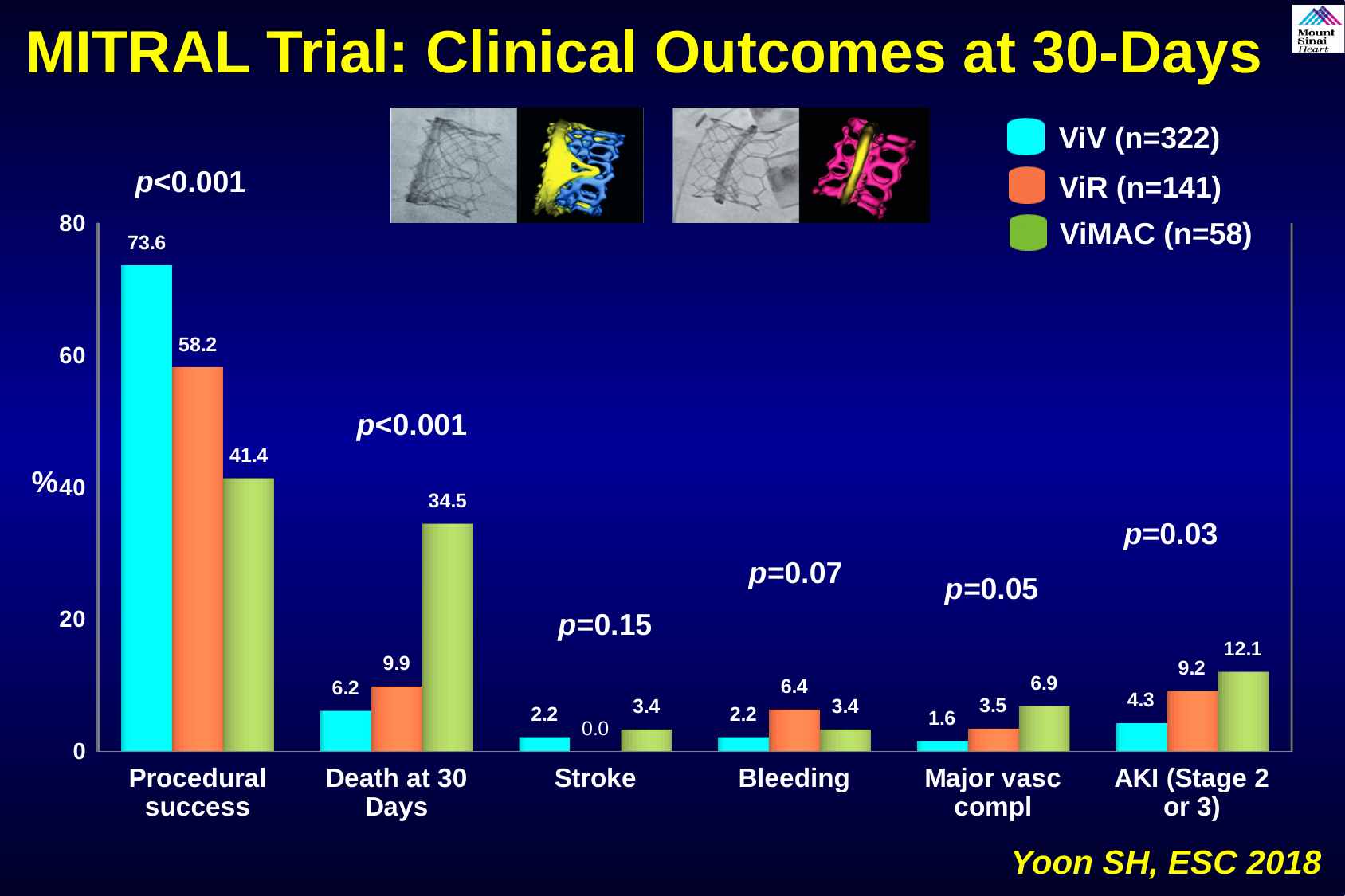
What is the p-value shown for the bleeding outcome? p=0.07 Which group has the lowest stroke value? ViR Which is larger, the AKI (Stage 2 or 3) value for ViR or for ViMAC? ViMAC What kind of chart is shown on the slide? bar chart What is the bleeding value for the ViR group? 6.4 What is the difference between the ViV and ViMAC procedural success values? 32.2 How many series does the legend list? 3 What is the procedural success value for the ViV group? 73.6 Is the death at 30 days value for ViMAC greater or less than 20? greater Which group has the highest procedural success? ViV How many outcome categories are shown on the x axis? 6 What is the death at 30 days value for the ViMAC group? 34.5